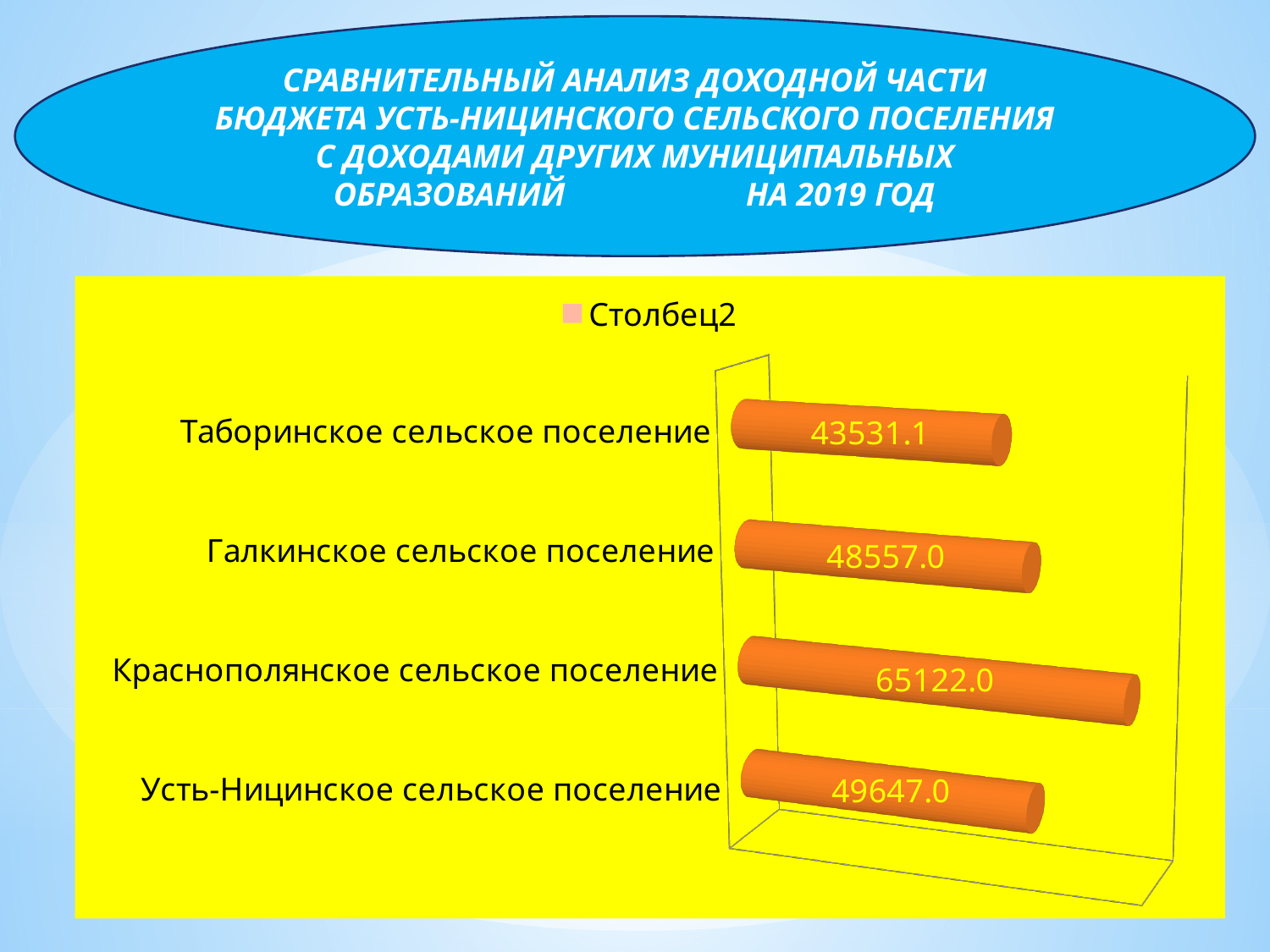
What kind of chart is shown on the slide? Bar chart What is the value for Таборинское сельское поселение? 43531.1 What is the value for Краснополянское сельское поселение? 65122.0 Which settlement has the highest value? Краснополянское сельское поселение How many settlements are shown in the chart? 4 Which is larger, the value for Галкинское сельское поселение or Таборинское сельское поселение? Галкинское сельское поселение What is the difference between the values for Усть-Ницинское сельское поселение and Галкинское сельское поселение? 1090.0 What is the difference between the values for Краснополянское сельское поселение and Усть-Ницинское сельское поселение? 15475.0 Which settlement has the lowest value? Таборинское сельское поселение What is the value for Усть-Ницинское сельское поселение? 49647.0 What is the value for Галкинское сельское поселение? 48557.0 What series name does the legend show? Столбец2